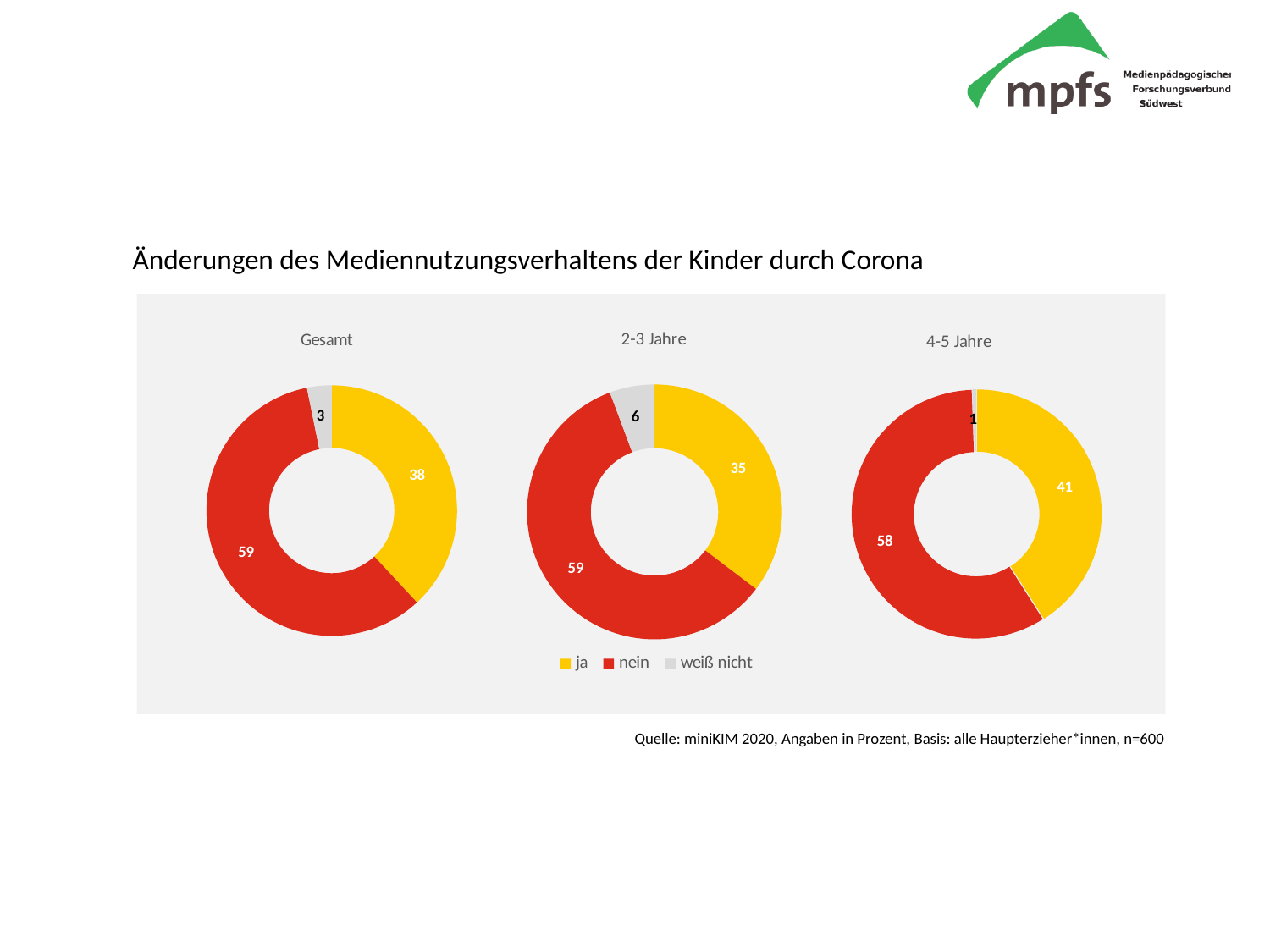
In the '4-5 Jahre' chart, what is the difference between 'nein' and 'ja'? 17 In the '2-3 Jahre' chart, which category has the smallest share? weiß nicht What kind of chart is used on this slide? Donut (pie) chart How many entries does the legend list? 3 What is the title of the slide's chart section? Änderungen des Mediennutzungsverhaltens der Kinder durch Corona In the 'Gesamt' chart, what is the value for 'nein'? 59 Which colour represents 'ja' in the charts? Yellow In the 'Gesamt' chart, which category has the largest share? nein How many categories does each donut chart show? 3 In the '4-5 Jahre' chart, what is the value for 'weiß nicht'? 1 In the '2-3 Jahre' chart, what is the value for 'ja'? 35 Is the value for 'ja' larger in the '2-3 Jahre' chart or in the '4-5 Jahre' chart? 4-5 Jahre